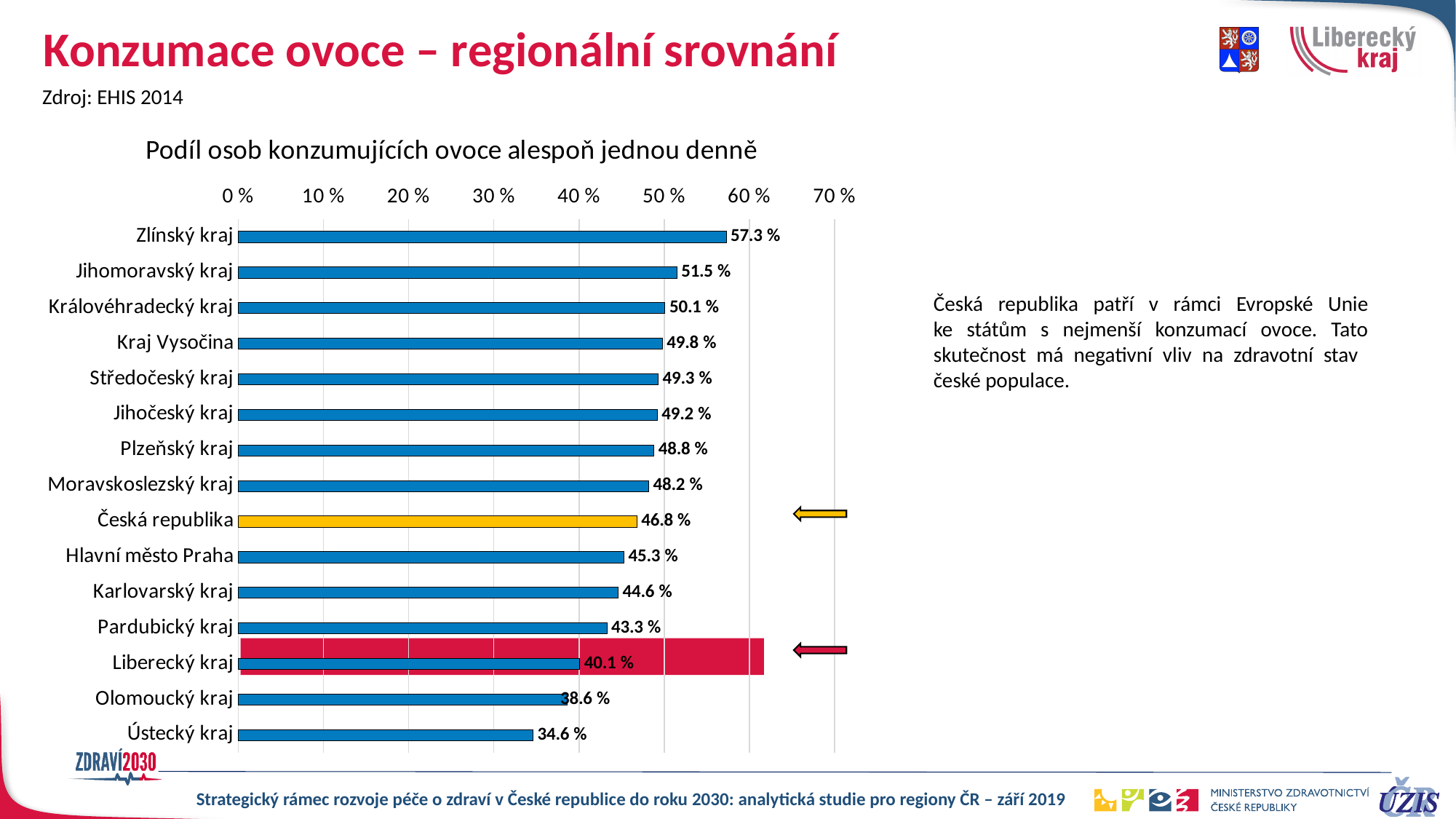
How many categories (bars) are shown in the chart? 15 What is the difference between the values for Zlínský kraj and Ústecký kraj? 22.7 percentage points What kind of chart is shown on the slide? Bar chart Which has a higher value, Jihomoravský kraj or Pardubický kraj? Jihomoravský kraj Which region has the highest share of people consuming fruit at least once a day? Zlínský kraj What is the value for Liberecký kraj? 40.1 % What is the value for Hlavní město Praha? 45.3 % What is the title of the chart? Podíl osob konzumujících ovoce alespoň jednou denně Which region has the lowest value in the chart? Ústecký kraj How much lower is the value for Liberecký kraj than the value for Česká republika? 6.7 percentage points What is the value for Česká republika? 46.8 % Is the value for Olomoucký kraj greater or less than 40 %? less